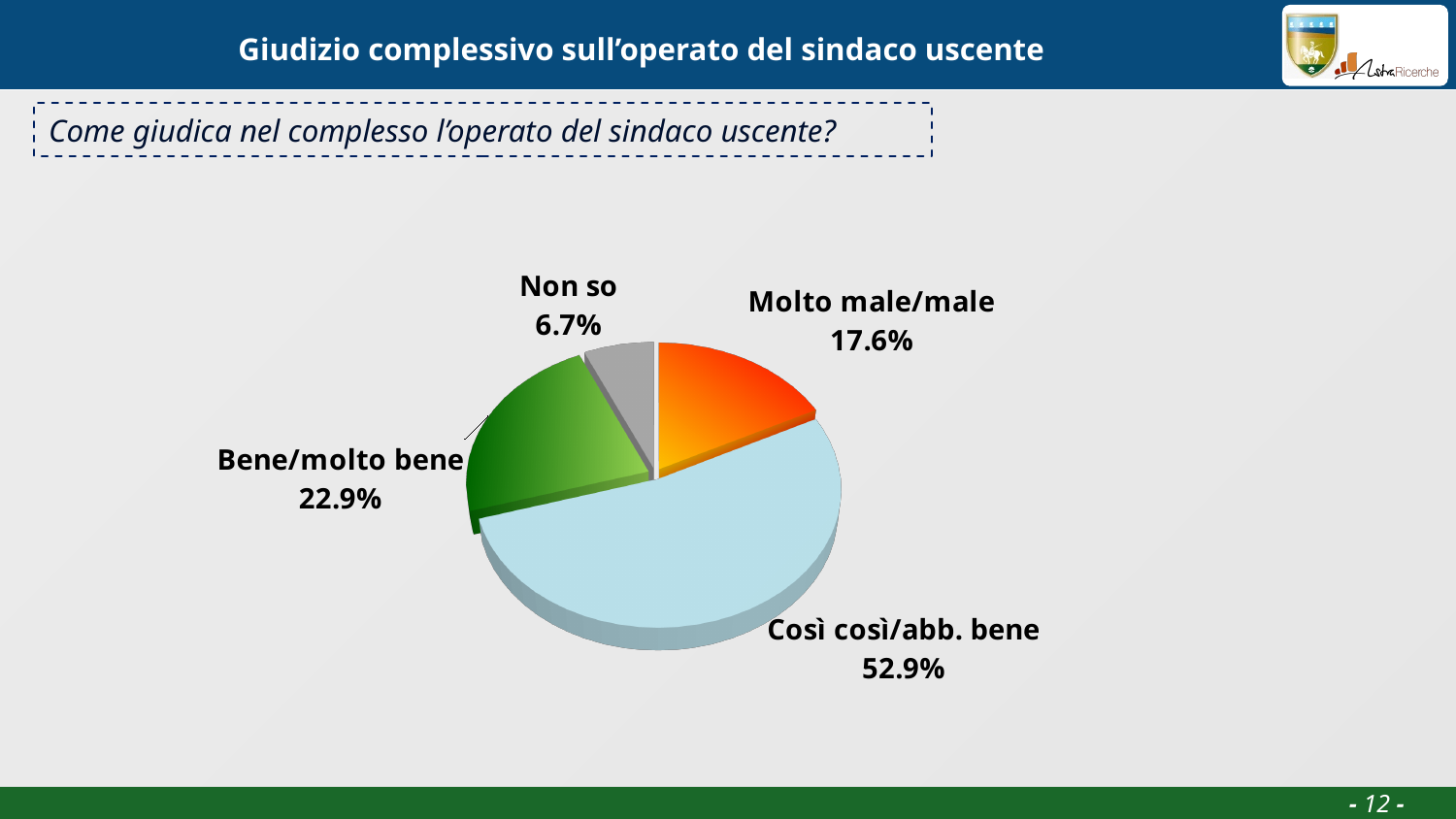
How many response categories are shown in the pie chart? 4 What percentage of respondents answered "Bene/molto bene"? 22.9% What percentage of respondents answered "Così così/abb. bene"? 52.9% What percentage of respondents answered "Molto male/male"? 17.6% Which response category has the largest share of the pie? Così così/abb. bene Which is larger: the share for "Bene/molto bene" or the share for "Molto male/male"? Bene/molto bene What percentage of respondents answered "Non so"? 6.7% Which response category has the smallest share of the pie? Non so What kind of chart is shown on the slide? Pie chart What is the difference in percentage points between "Così così/abb. bene" and "Non so"? 46.2 What colour is the slice for "Bene/molto bene"? Green What is the difference in percentage points between "Bene/molto bene" and "Molto male/male"? 5.3